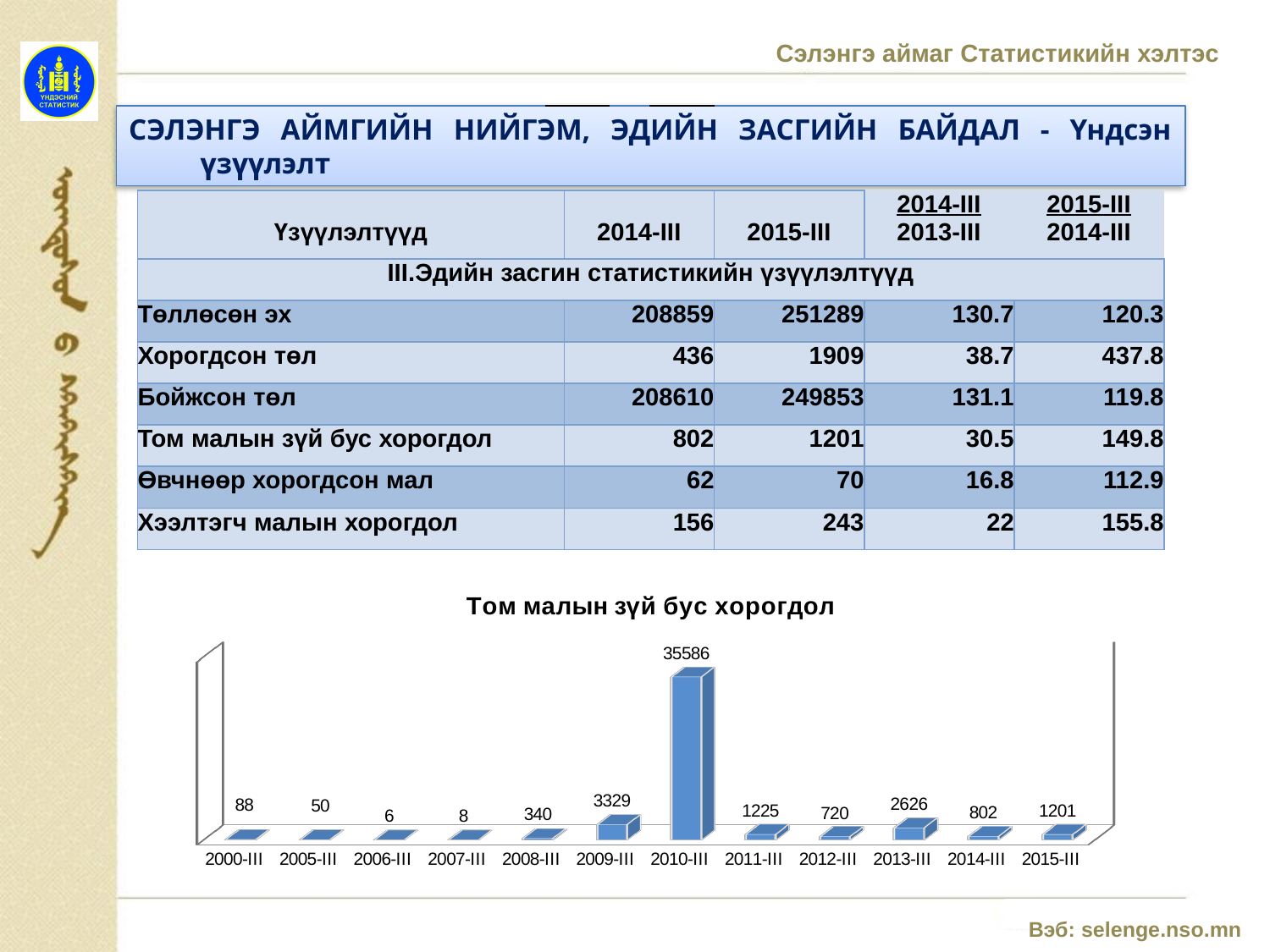
In the chart 'Том малын зүй бус хорогдол', does the value rise or fall from 2010-III to 2011-III? Fall What kind of chart is 'Том малын зүй бус хорогдол'? Bar chart In the chart 'Том малын зүй бус хорогдол', what is the value for 2009-III? 3329 In the chart 'Том малын зүй бус хорогдол', what is the value for 2010-III? 35586 In the chart 'Том малын зүй бус хорогдол', what is the value for 2015-III? 1201 In the chart 'Том малын зүй бус хорогдол', what is the difference between the values for 2015-III and 2014-III? 399 What is the title of the chart at the bottom of the slide? Том малын зүй бус хорогдол In the chart 'Том малын зүй бус хорогдол', which period has the highest value? 2010-III How many periods are shown on the x axis of the chart 'Том малын зүй бус хорогдол'? 12 In the chart 'Том малын зүй бус хорогдол', what is the difference between the values for 2013-III and 2012-III? 1906 In the chart 'Том малын зүй бус хорогдол', which period has the lowest value? 2006-III In the chart 'Том малын зүй бус хорогдол', which is larger: the value for 2011-III or 2012-III? 2011-III